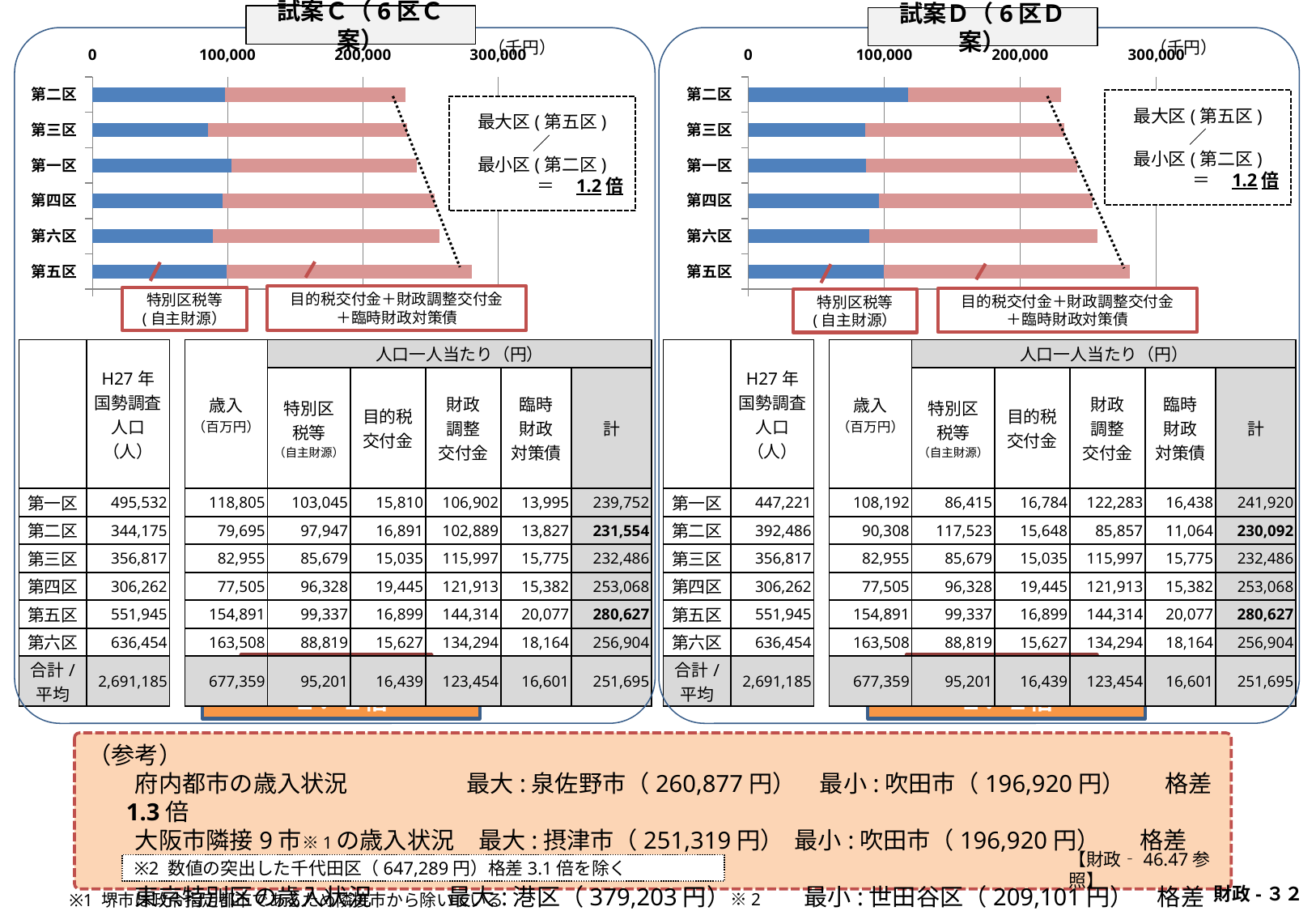
In the 試案D（6区D案） chart, which district has the larger 特別区税等（自主財源） segment, 第二区 or 第三区? 第二区 In the 試案C（6区C案） chart, which district has the longest total bar? 第五区 In the 試案C（6区C案） chart, is the total bar for 第五区 greater or less than 200,000? greater How many series does the legend of the 試案D（6区D案） chart list? 2 What kind of chart is the 試案C（6区C案） chart? bar chart In the 試案D（6区D案） chart, which district has the shortest total bar? 第二区 In the 試案D（6区D案） chart, which district has the longest total bar? 第五区 In the 試案C（6区C案） chart, which district has the shortest total bar? 第二区 In the 試案D（6区D案） chart, what is the 特別区税等（自主財源） value for 第二区 as shown in the table? 117,523 How many districts (categories) are plotted in the 試案C（6区C案） chart? 6 In the 試案C（6区C案） chart, what is the difference between the per-capita total (計) of 第五区 and 第二区? 49,073 In the 試案C（6区C案） chart, what is the per-capita total (計) for 第五区 as shown in the table? 280,627